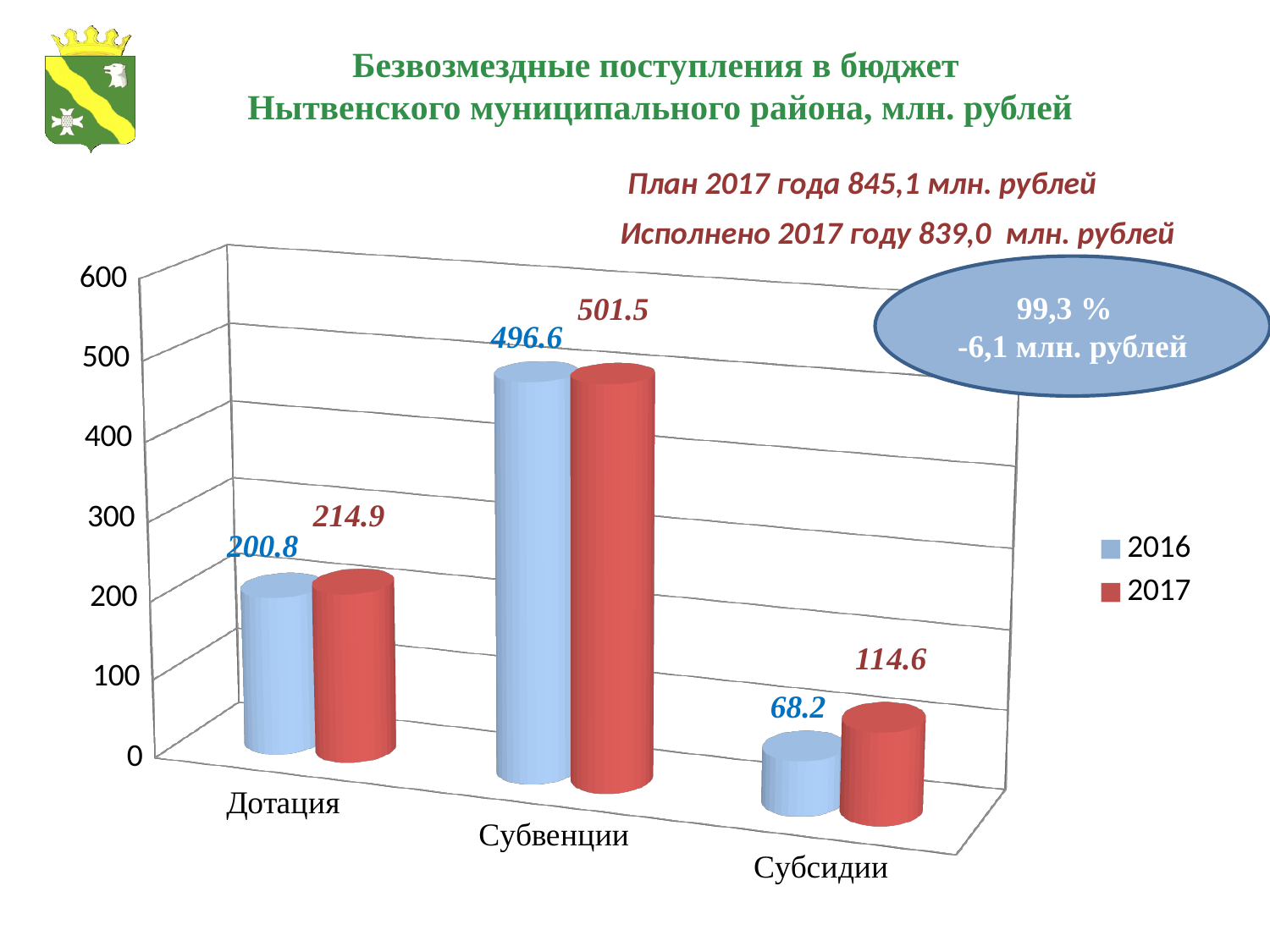
What is the value for Субсидии in 2016? 68.2 What is the value for Субсидии in 2017? 114.6 What is the difference between the 2017 and 2016 values for Дотация? 14.1 What kind of chart is shown on the slide? bar chart Which is larger for Субвенции: the 2016 value or the 2017 value? 2017 How many series does the legend list? 2 What is the difference between the 2017 and 2016 values for Субсидии? 46.4 Which category has the lowest value in 2016? Субсидии What is the value for Дотация in 2016? 200.8 How many categories are shown on the x axis? 3 Which category has the highest value in 2017? Субвенции What is the value for Субвенции in 2017? 501.5